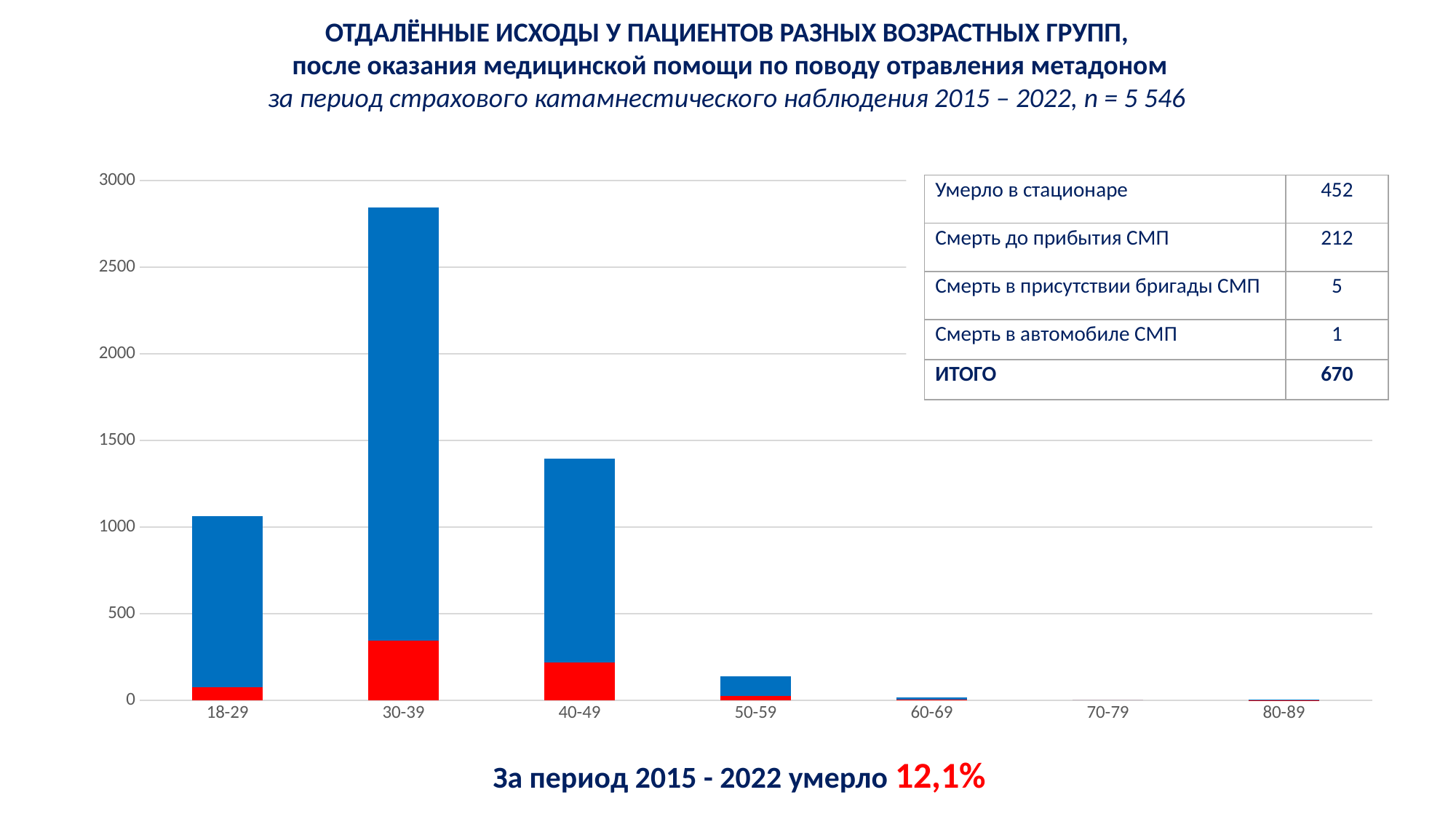
Which age group has the tallest bar in the chart? 30-39 Which age group has the largest red segment in the chart? 30-39 Is the total bar height for the 30-39 age group greater or less than 2500? greater What kind of chart is shown on the slide? bar chart How many age groups are shown on the x axis of the chart? 7 Is the total bar height for the 50-59 age group greater or less than 500? less Is the total bar height for the 40-49 age group greater or less than 1500? less Which bar is taller, 50-59 or 60-69? 50-59 What is the first age group label on the x axis of the chart? 18-29 What is the highest value shown on the y axis of the chart? 3000 Which bar is taller, 40-49 or 18-29? 40-49